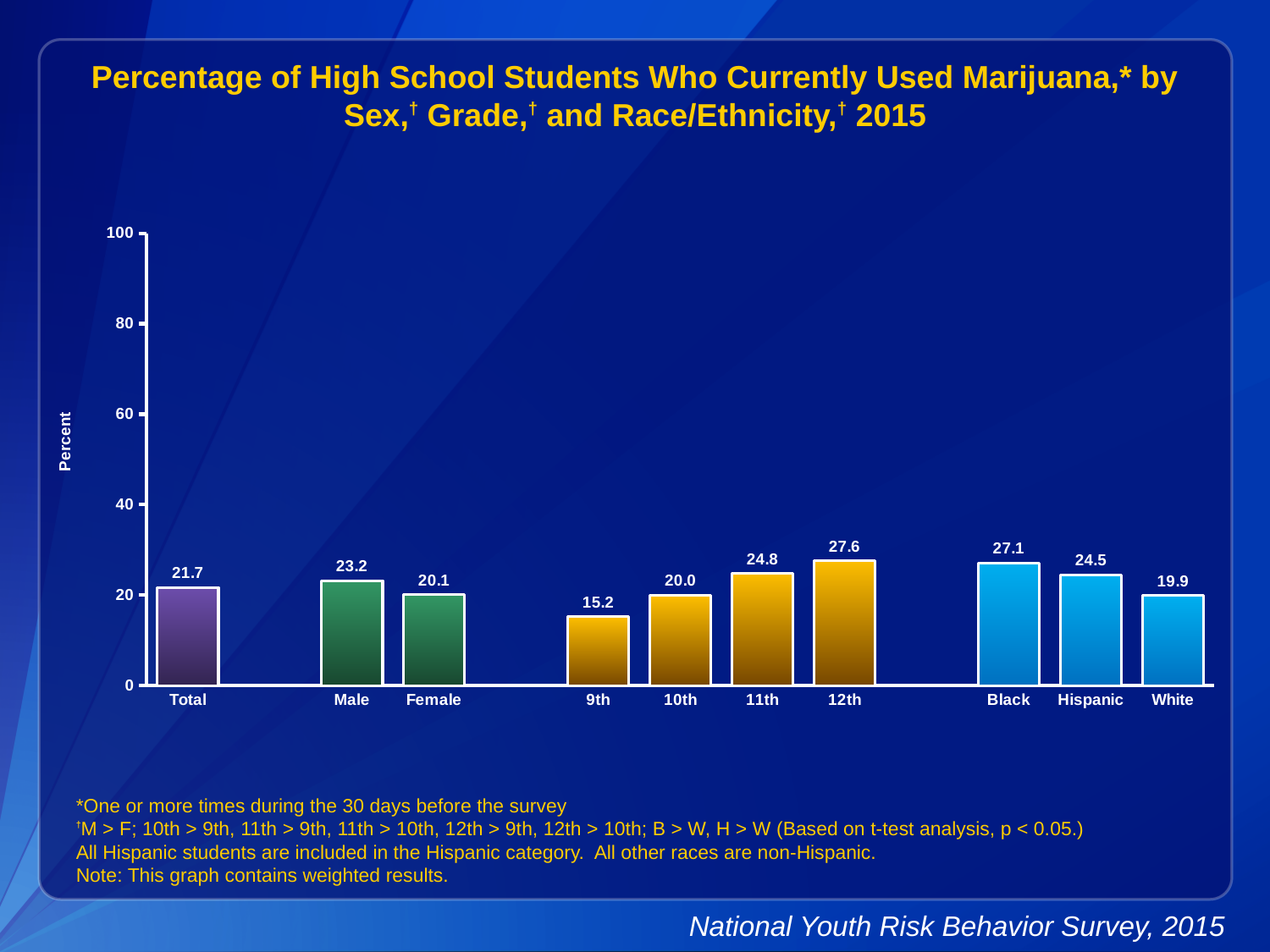
What is the value for Male? 23.2 What kind of chart is shown on the slide? Bar chart Which is larger, the value for Black or the value for White? Black What is the value for Total? 21.7 Do the values rise or fall from 9th grade to 12th grade? Rise What is the difference between the values for 12th and 9th grade? 12.4 Which category has the lowest value? 9th What is the value for Hispanic? 24.5 How many bars are shown in the chart? 10 What is the difference between the values for Male and Female? 3.1 Which category has the highest value? 12th What is the value for 9th grade? 15.2